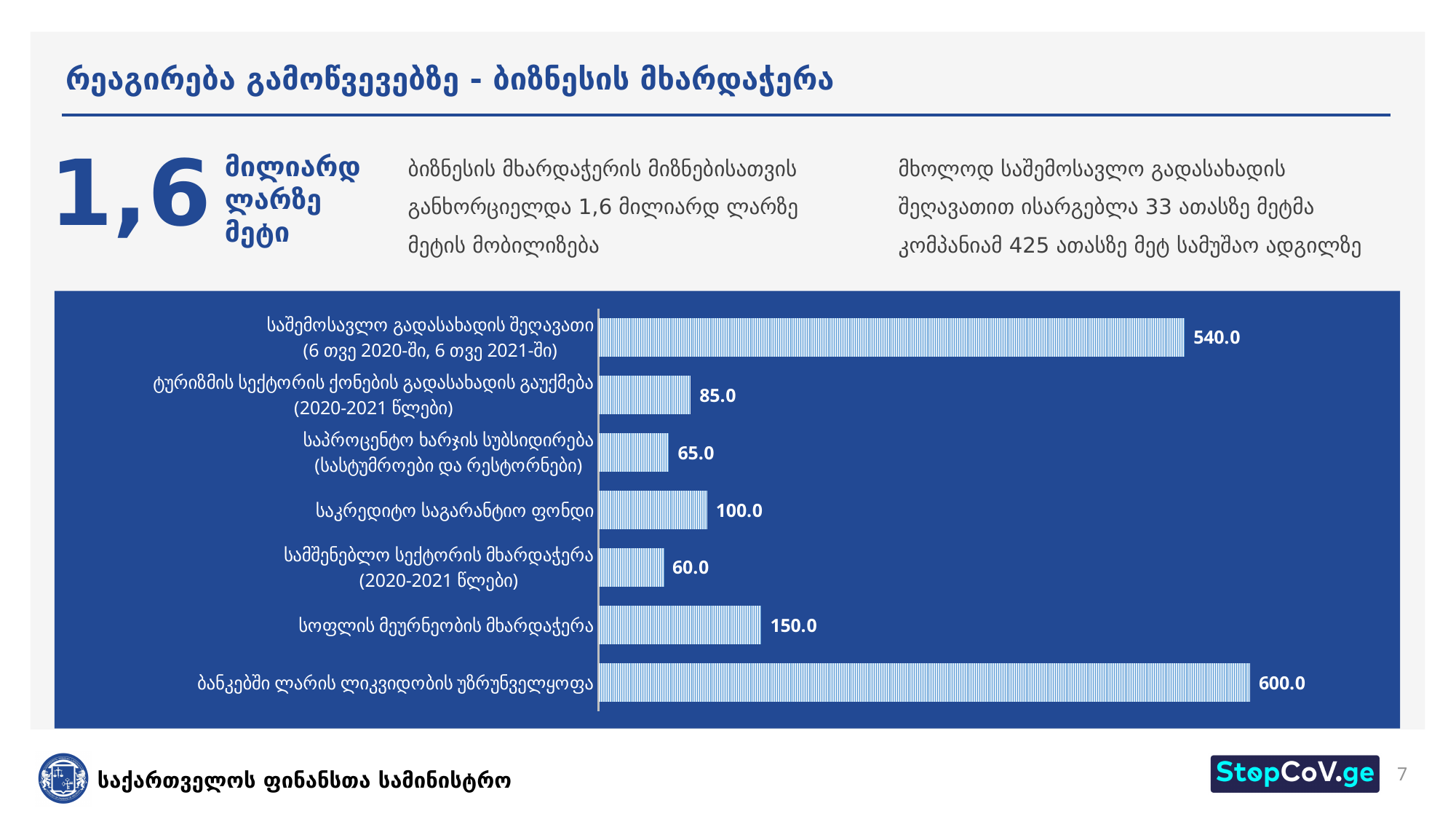
What is the difference between the values for ბანკებში ლარის ლიკვიდობის უზრუნველყოფა and საშემოსავლო გადასახადის შეღავათი? 60.0 Which category has the highest value? ბანკებში ლარის ლიკვიდობის უზრუნველყოფა What is the value for სოფლის მეურნეობის მხარდაჭერა? 150.0 How many categories are shown in the chart? 7 Which is larger: the value for ტურიზმის სექტორის ქონების გადასახადის გაუქმება or the value for საპროცენტო ხარჯის სუბსიდირება? ტურიზმის სექტორის ქონების გადასახადის გაუქმება What kind of chart is shown on the slide? bar chart What is the difference between the values for სოფლის მეურნეობის მხარდაჭერა and საკრედიტო საგარანტიო ფონდი? 50.0 What is the value for ტურიზმის სექტორის ქონების გადასახადის გაუქმება (2020-2021 წლები)? 85.0 What is the value for საკრედიტო საგარანტიო ფონდი? 100.0 What is the value for საშემოსავლო გადასახადის შეღავათი (6 თვე 2020-ში, 6 თვე 2021-ში)? 540.0 Which category has the lowest value? სამშენებლო სექტორის მხარდაჭერა (2020-2021 წლები) What is the value for საპროცენტო ხარჯის სუბსიდირება (სასტუმროები და რესტორნები)? 65.0